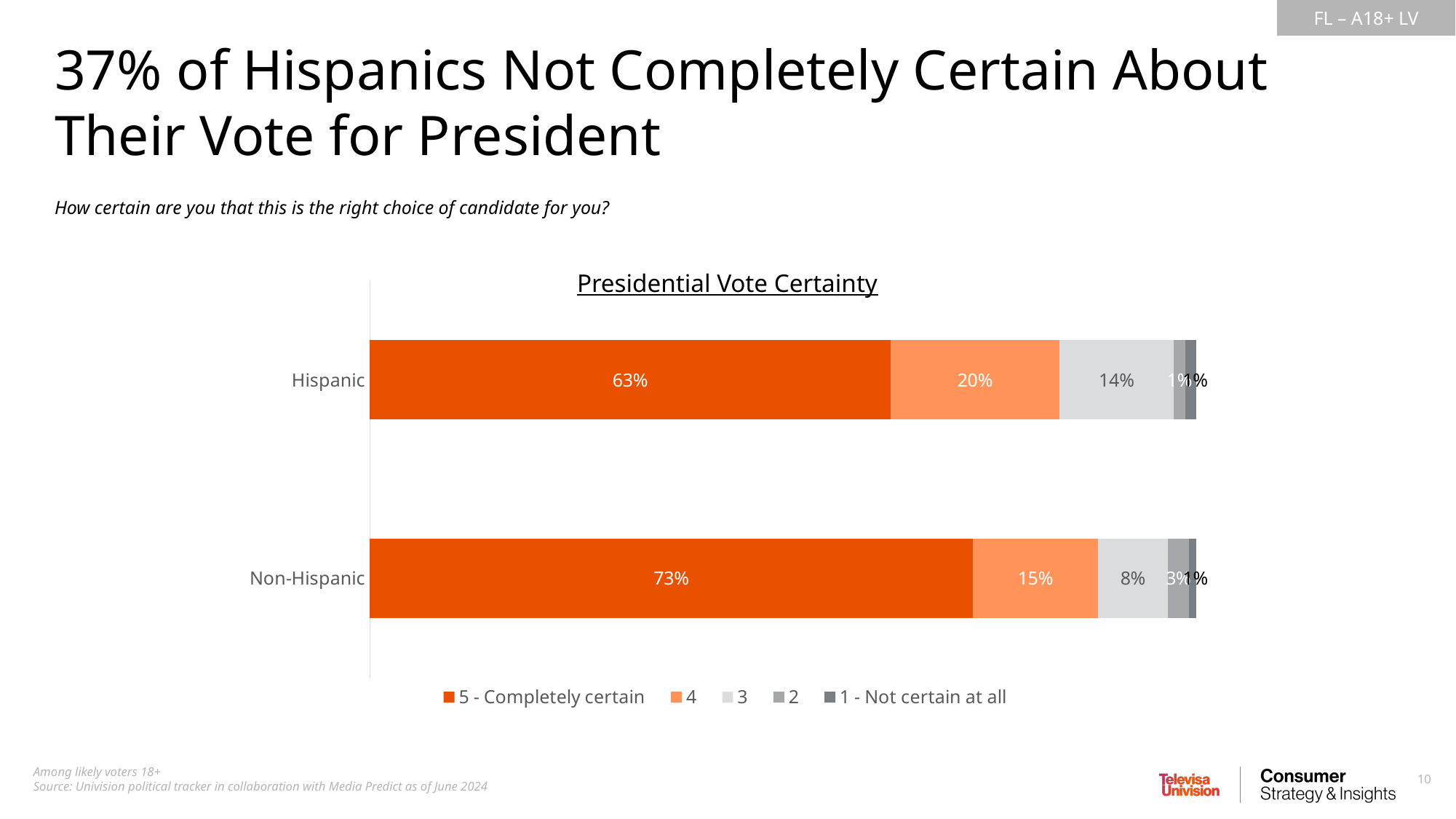
What percentage of Hispanic likely voters are "5 - Completely certain" in the Presidential Vote Certainty chart? 63% How many percentage points higher is the "5 - Completely certain" share for Non-Hispanic than for Hispanic? 10 percentage points What is the difference between the "3" segment for Hispanic and for Non-Hispanic? 6 percentage points What type of chart is shown on the slide? Stacked bar chart What is the value of the "4" segment for Non-Hispanic? 15% How many series does the legend list? 5 Which group has the larger "4" segment, Hispanic or Non-Hispanic? Hispanic What is the value of the "3" segment for Non-Hispanic? 8% How many groups (categories) are shown in the chart? 2 What percentage of Non-Hispanic likely voters are "5 - Completely certain"? 73% What is the value of the "4" segment for Hispanic? 20% What is the value of the "3" segment for Hispanic? 14%